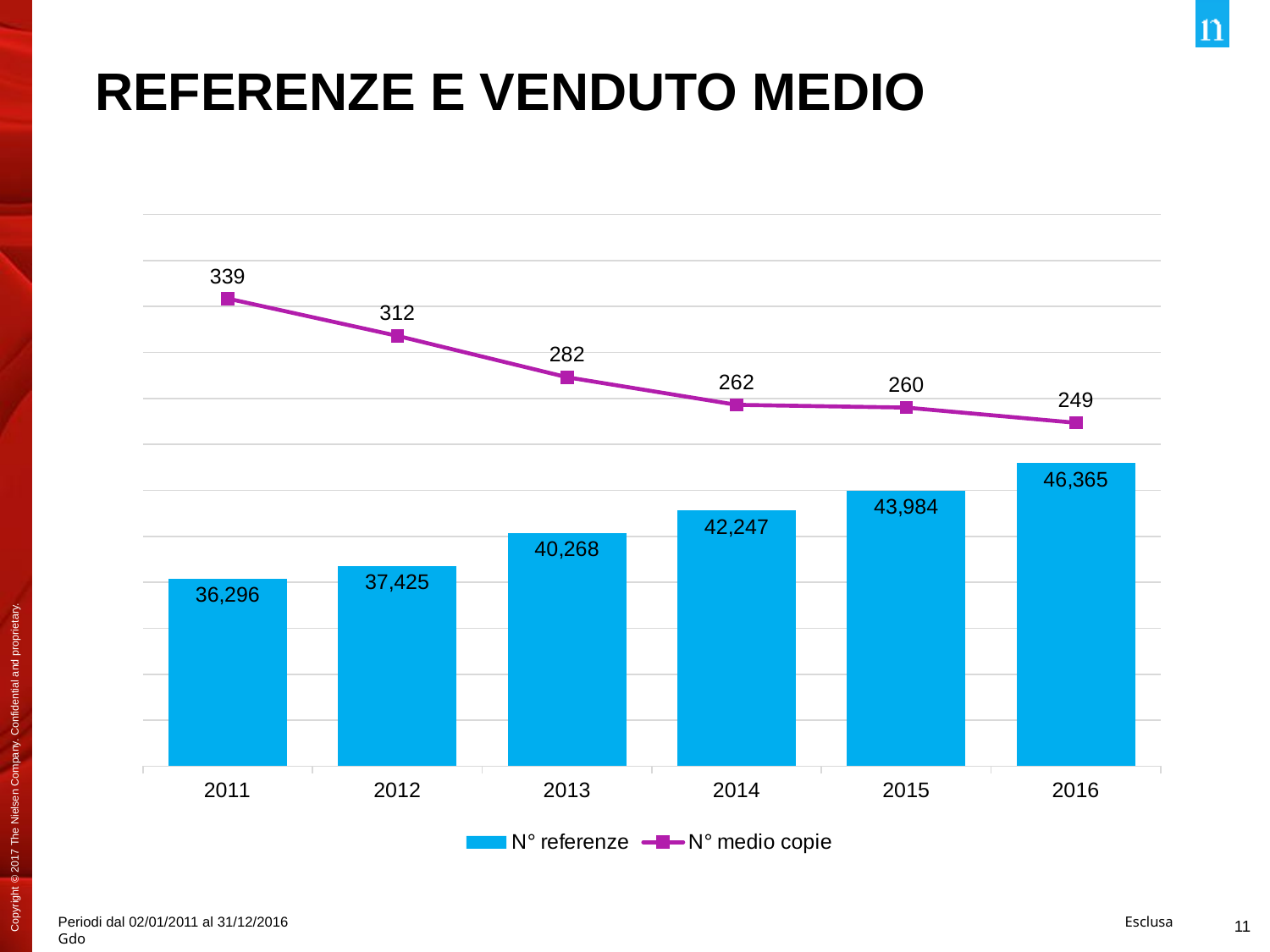
What is the difference in N° medio copie between 2011 and 2012? 27 Which series is drawn as a line with square markers? N° medio copie What is the value of N° medio copie for 2016? 249 What is the value of N° medio copie for 2011? 339 How many series does the legend list? 2 What is the value of N° referenze for 2013? 40,268 Which year has the highest N° referenze? 2016 What is the difference in N° referenze between 2016 and 2011? 10,069 How many years are shown on the x axis? 6 Which is larger, N° referenze in 2014 or in 2015? 2015 Does N° medio copie rise or fall from 2011 to 2016? fall Which year has the lowest N° medio copie? 2016